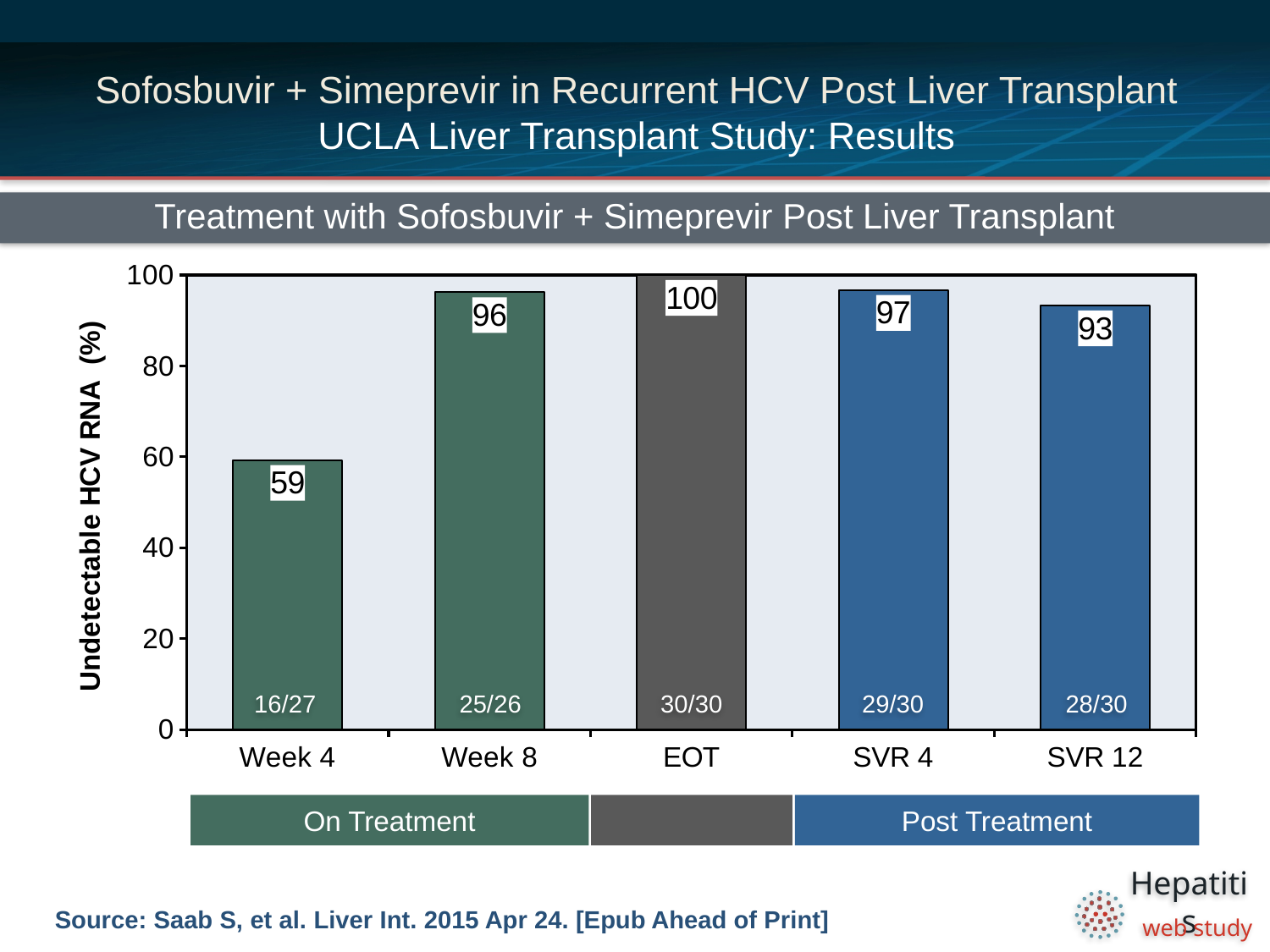
Which category has the lowest value? Week 4 Which category has the highest value? EOT What is the value for Week 4? 59 What kind of chart is shown on the slide? bar chart Which is larger, the value for SVR 4 or the value for SVR 12? SVR 4 What is the value for EOT? 100 Is the value for Week 4 greater or less than 60? less How many categories are shown on the x axis? 5 What fraction is printed inside the SVR 4 bar? 29/30 What is the title of the chart? Treatment with Sofosbuvir + Simeprevir Post Liver Transplant What is the value for SVR 12? 93 What is the difference between the values for Week 8 and Week 4? 37